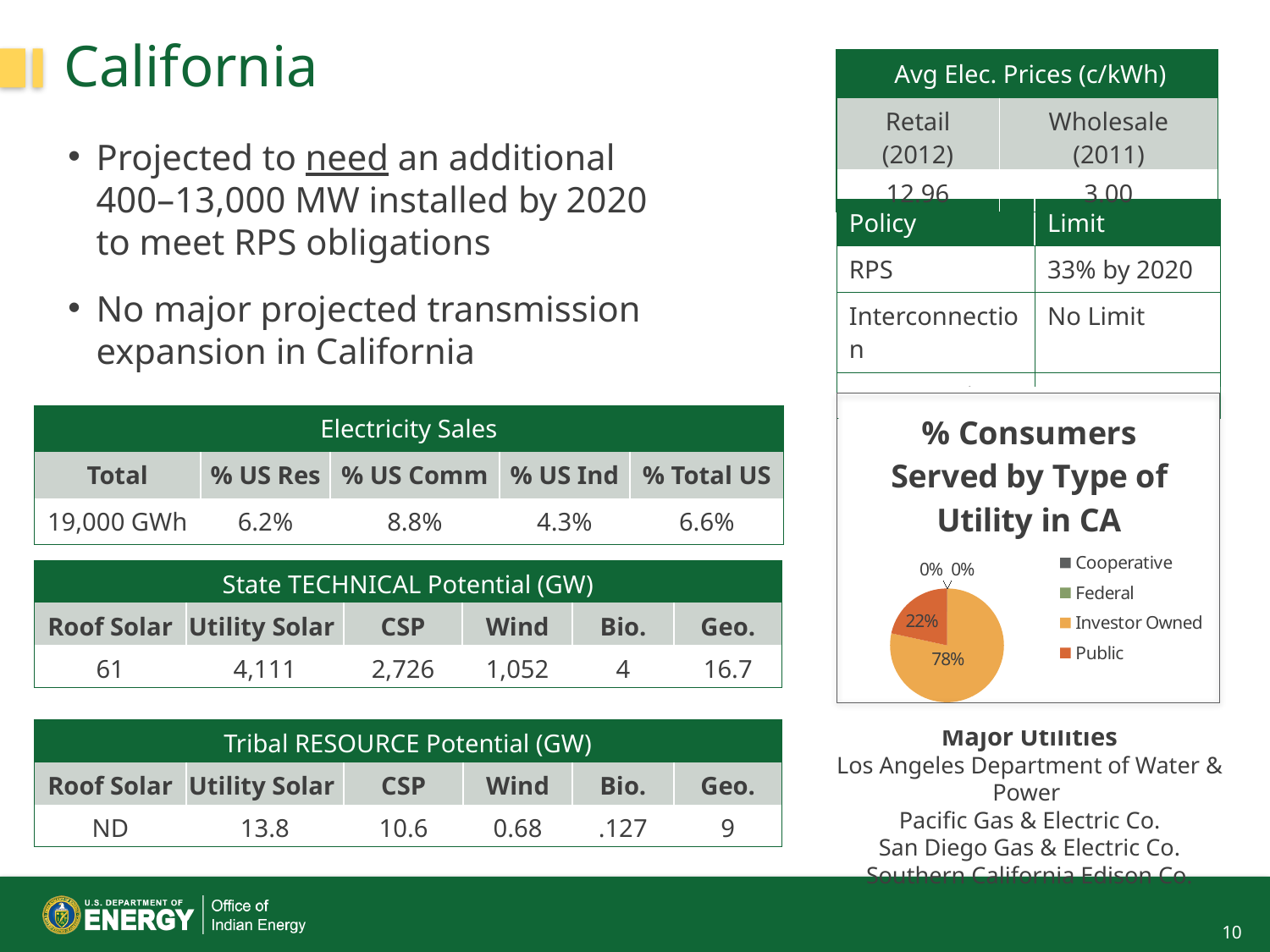
Which utility type serves the largest share of consumers in the pie chart? Investor Owned In the pie chart, what share of consumers is served by Federal utilities? 0% In the pie chart, which serves a larger share of consumers: Investor Owned or Public? Investor Owned In the pie chart, what share of consumers is served by Public utilities? 22% What type of chart is used to show % Consumers Served by Type of Utility in CA? pie chart In the pie chart, what share of consumers is served by Investor Owned utilities? 78% In the pie chart, what is the difference in percentage points between the Investor Owned share and the Public share? 56 percentage points In the pie chart, is the Public share greater or less than 50%? less What is the title of the pie chart? % Consumers Served by Type of Utility in CA How many utility types does the pie chart legend list? 4 In the pie chart, what is the combined share of Investor Owned and Public utilities? 100%